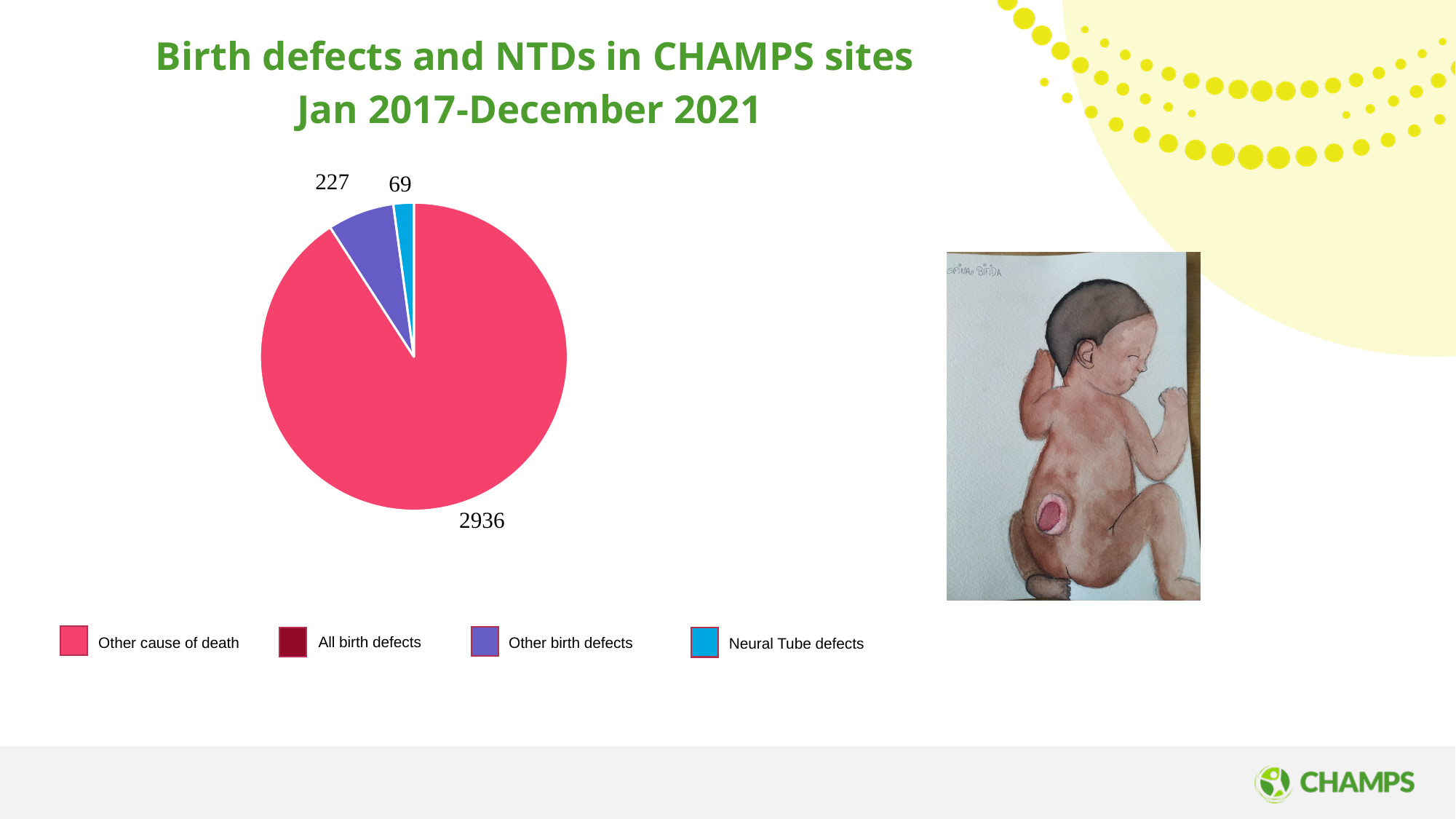
What is the difference between the values for Other birth defects and Neural Tube defects? 158 What is the value shown for Neural Tube defects in the pie chart? 69 How many entries does the legend list? 4 What is the value shown for Other birth defects in the pie chart? 227 What kind of chart is shown on the slide? Pie chart What is the difference between the values for Other cause of death and Other birth defects? 2709 Which labelled category has the smallest slice in the pie chart? Neural Tube defects What colour represents Neural Tube defects in the pie chart? Blue Which is larger, the value for Other birth defects or the value for Neural Tube defects? Other birth defects Which category has the largest slice in the pie chart? Other cause of death What is the title of the slide containing the pie chart? Birth defects and NTDs in CHAMPS sites Jan 2017-December 2021 What is the value shown for Other cause of death in the pie chart? 2936